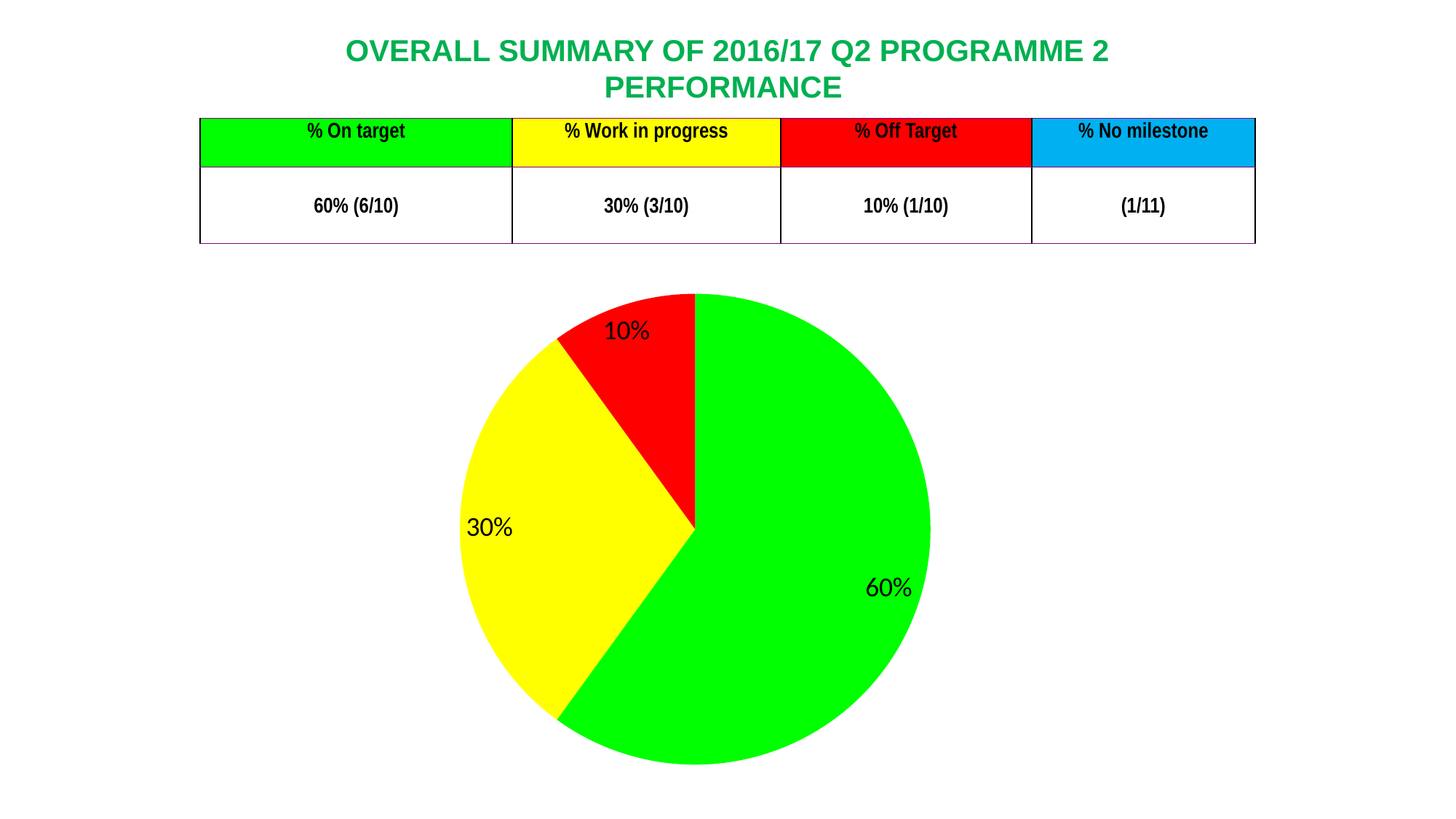
According to the table colours, which category does the green slice of the pie chart represent? % On target What is the title of the slide containing the pie chart? OVERALL SUMMARY OF 2016/17 Q2 PROGRAMME 2 PERFORMANCE What percentage is shown on the yellow slice of the pie chart? 30% Which slice of the pie chart is the largest? the green slice (60%) Which slice of the pie chart is the smallest? the red slice (10%) How many slices does the pie chart have? 3 What is the difference between the green slice and the yellow slice of the pie chart? 30% What share of the pie does the red slice represent? 10% What kind of chart is shown on the slide? pie chart What percentage is shown on the red slice of the pie chart? 10% What percentage is shown on the green slice of the pie chart? 60% Which is larger in the pie chart, the yellow slice or the red slice? the yellow slice